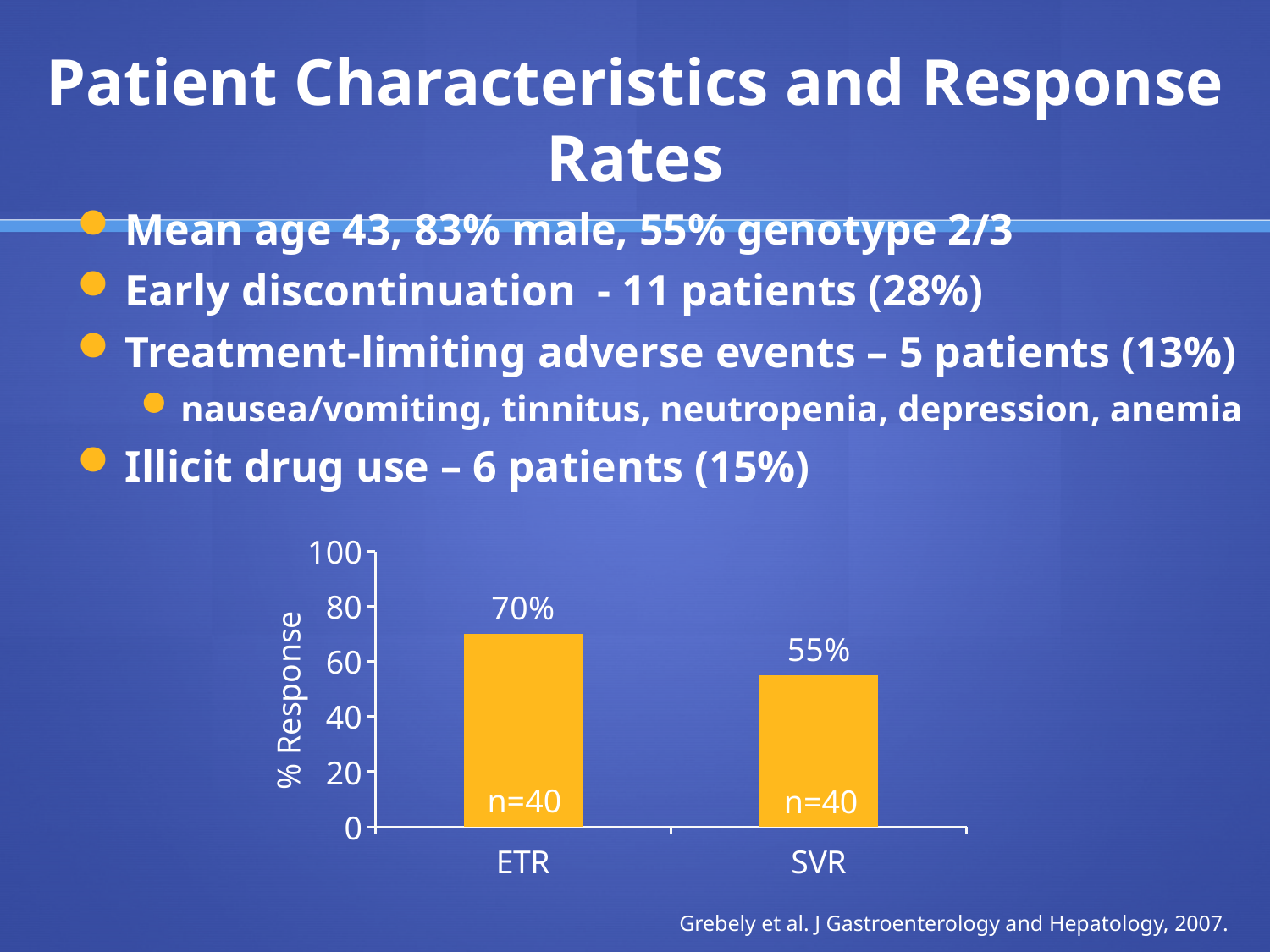
What is the label of the y axis of the chart? % Response Which category has the lowest % Response? SVR Which category has the higher % Response, ETR or SVR? ETR Is the value for ETR greater or less than 60? greater What is the % Response value for SVR? 55% What kind of chart is shown on the slide? Bar chart Which category has the highest % Response? ETR Is the value for SVR greater or less than 60? less How many categories are shown on the x axis of the chart? 2 What sample size (n) is printed on each bar of the chart? n=40 What is the difference in % Response between ETR and SVR? 15% What is the % Response value for ETR? 70%